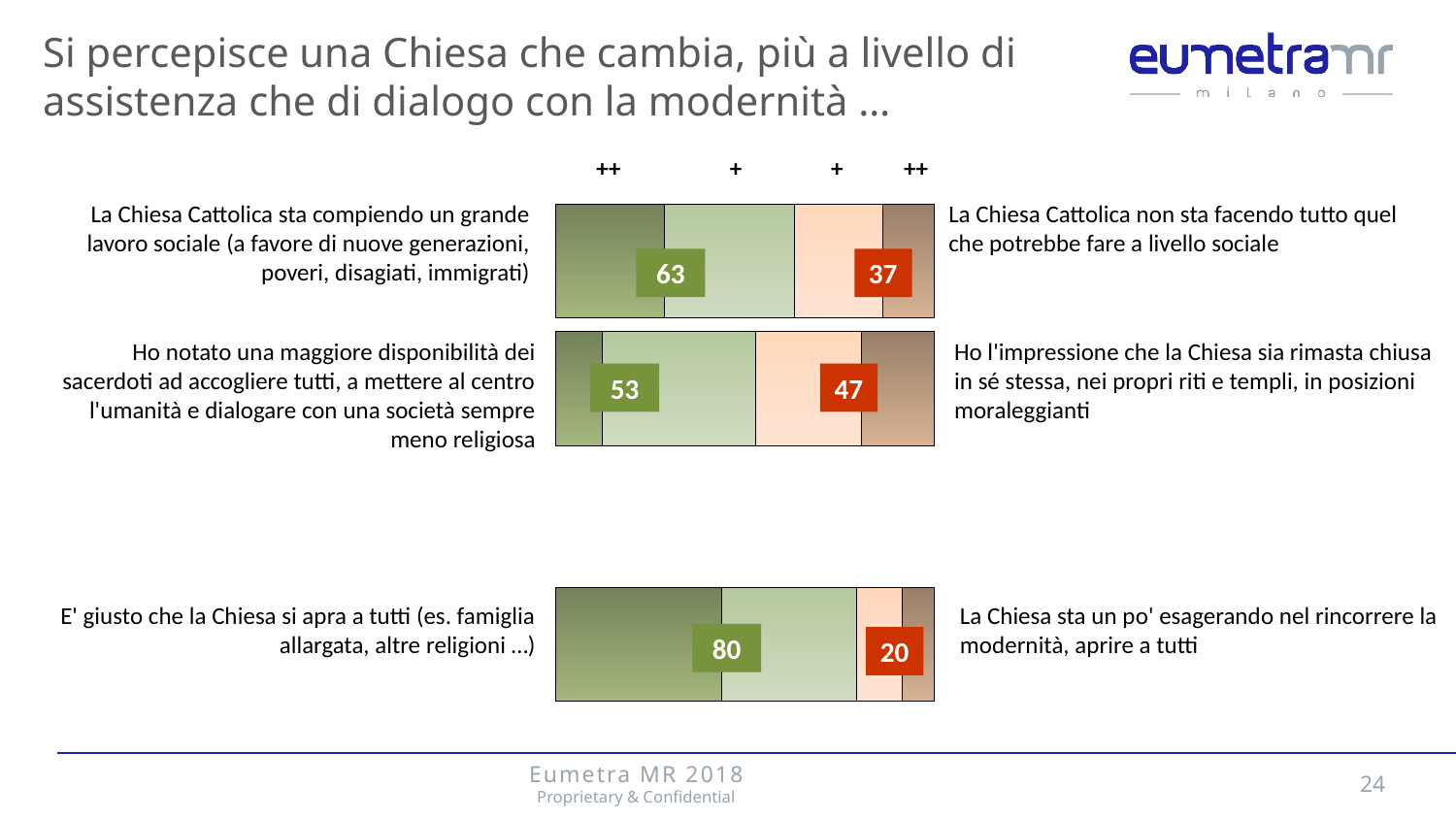
Which of the right-hand statements has the lowest value? La Chiesa sta un po' esagerando nel rincorrere la modernità, aprire a tutti What value is shown for the statement "Ho l'impressione che la Chiesa sia rimasta chiusa in sé stessa, nei propri riti e templi, in posizioni moraleggianti"? 47 What value is shown for the statement "La Chiesa Cattolica non sta facendo tutto quel che potrebbe fare a livello sociale"? 37 What is the difference between the value for "La Chiesa Cattolica sta compiendo un grande lavoro sociale" and the value for "La Chiesa Cattolica non sta facendo tutto quel che potrebbe fare a livello sociale"? 26 Which is larger: the value for "Ho notato una maggiore disponibilità dei sacerdoti ad accogliere tutti" or the value for "Ho l'impressione che la Chiesa sia rimasta chiusa in sé stessa"? Ho notato una maggiore disponibilità dei sacerdoti ad accogliere tutti What value is shown for the statement "La Chiesa sta un po' esagerando nel rincorrere la modernità, aprire a tutti"? 20 What value is shown for the statement "E' giusto che la Chiesa si apra a tutti (es. famiglia allargata, altre religioni …)"? 80 What value is shown for the statement "La Chiesa Cattolica sta compiendo un grande lavoro sociale (a favore di nuove generazioni, poveri, disagiati, immigrati)"? 63 How many stacked bars are shown on the slide? 3 Which of the left-hand statements has the highest value? E' giusto che la Chiesa si apra a tutti (es. famiglia allargata, altre religioni …) What value is shown for the statement "Ho notato una maggiore disponibilità dei sacerdoti ad accogliere tutti, a mettere al centro l'umanità e dialogare con una società sempre meno religiosa"? 53 What kind of chart is shown on the slide? Bar chart